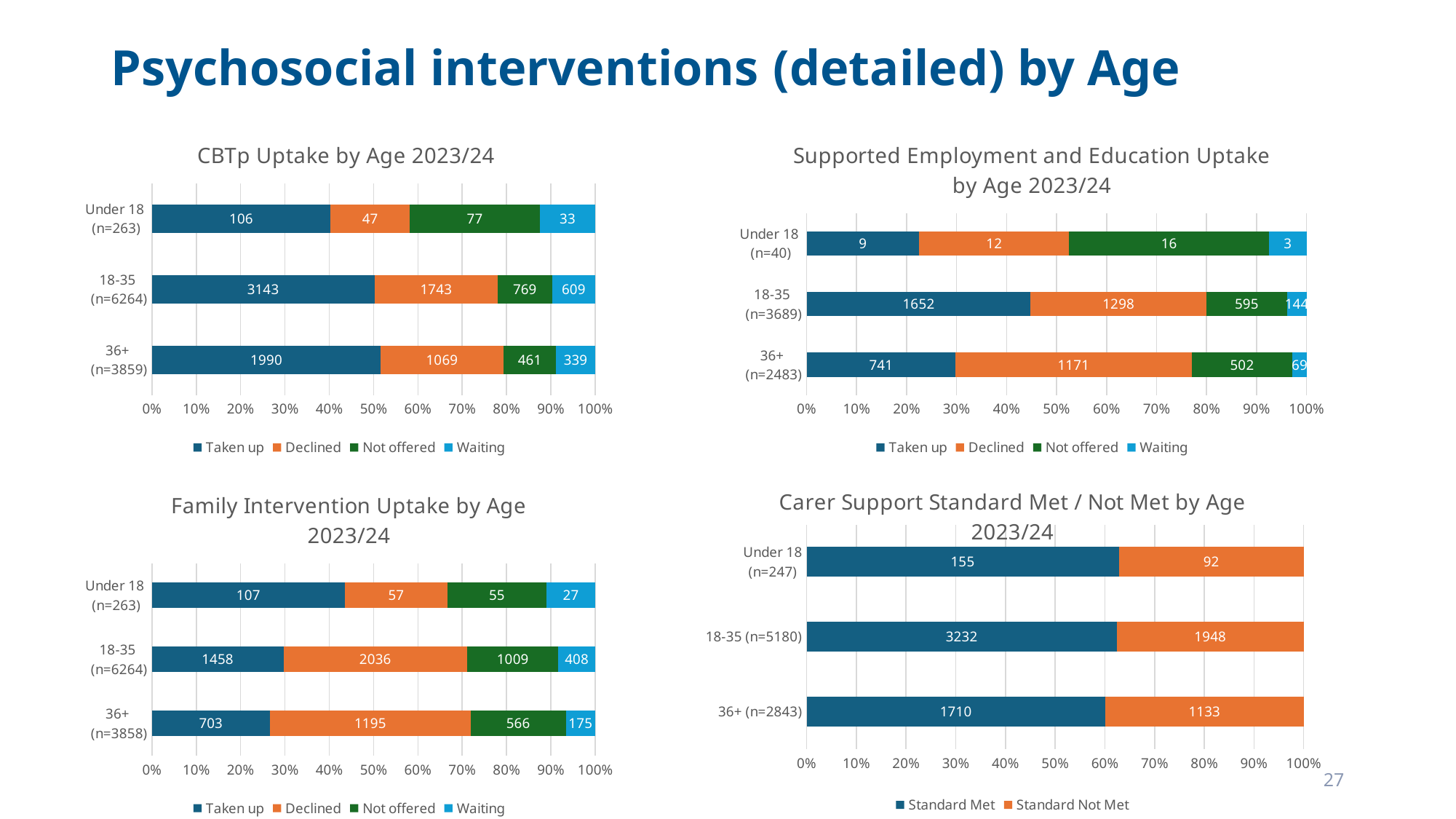
In the Carer Support Standard Met / Not Met by Age 2023/24 chart, which age group has the lowest Standard Not Met count? Under 18 In the CBTp Uptake by Age 2023/24 chart, is the Declined value for 18-35 larger or smaller than the Declined value for 36+? larger In the Family Intervention Uptake by Age 2023/24 chart, what is the Not offered value for the 18-35 group? 1009 What type of chart is the Family Intervention Uptake by Age 2023/24 chart? Stacked bar chart In the Carer Support Standard Met / Not Met by Age 2023/24 chart, what is the difference between Standard Met and Standard Not Met for the 18-35 group? 1284 How many age groups are shown in the Supported Employment and Education Uptake by Age 2023/24 chart? 3 In the Supported Employment and Education Uptake by Age 2023/24 chart, which age group has the highest Taken up count? 18-35 In the CBTp Uptake by Age 2023/24 chart, what is the Waiting value for the 36+ group? 339 How many series does the legend of the Carer Support Standard Met / Not Met by Age 2023/24 chart list? 2 In the Supported Employment and Education Uptake by Age 2023/24 chart, how many people aged 36+ Declined? 1171 In the CBTp Uptake by Age 2023/24 chart, how many people aged 18-35 were Taken up? 3143 In the Family Intervention Uptake by Age 2023/24 chart, what is the total of the 36+ bar? 2639